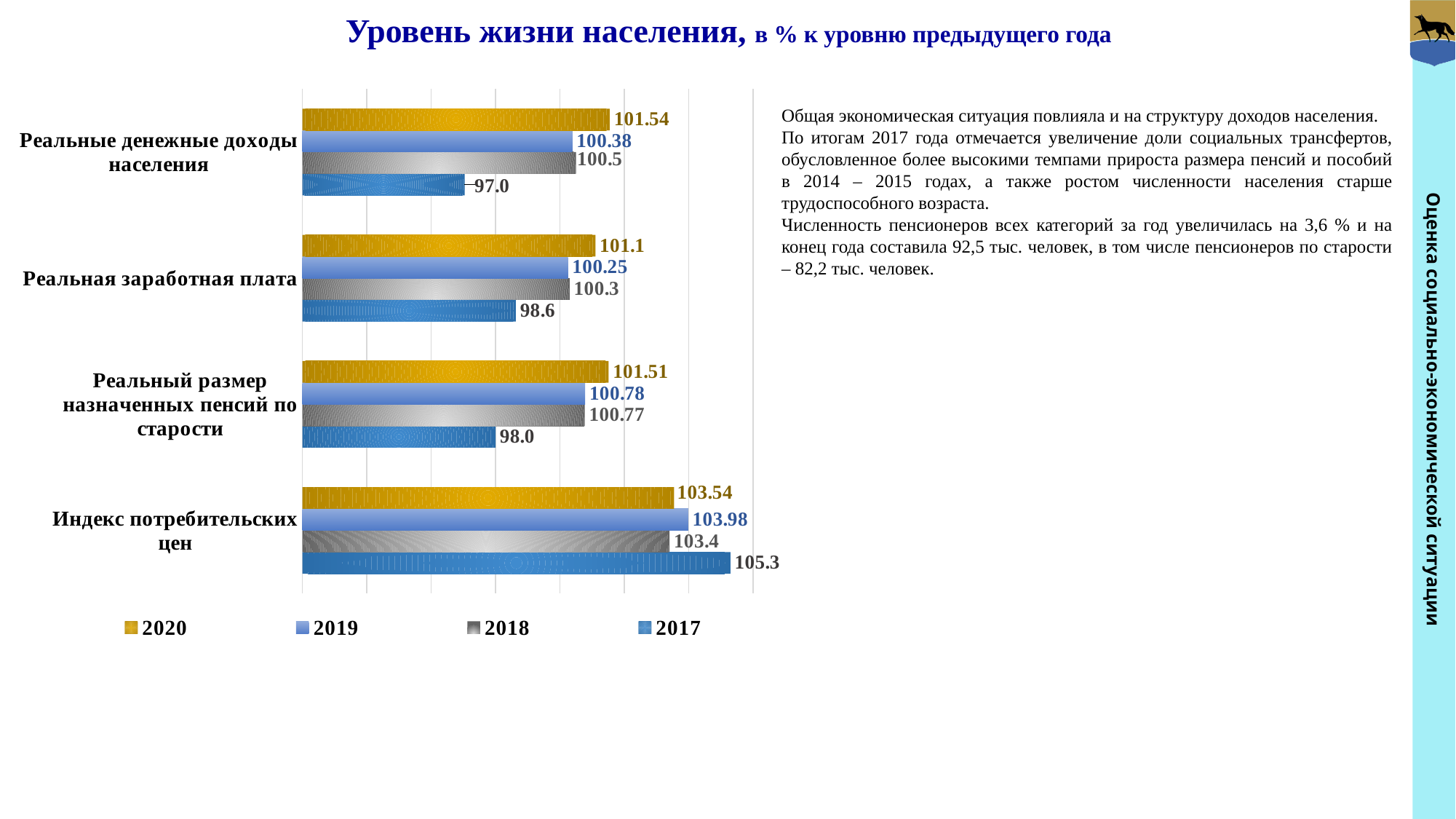
Which series is shown in gold/yellow on the chart? 2020 How many series does the legend list? 4 What is the value for 2017 for Индекс потребительских цен? 105.3 Which is larger for Реальный размер назначенных пенсий по старости: the 2020 value or the 2017 value? 2020 What is the difference between the 2020 and 2017 values for Реальная заработная плата? 2.5 What is the value for 2020 for Реальные денежные доходы населения? 101.54 Which year has the highest value for Индекс потребительских цен? 2017 Which year has the lowest value for Реальные денежные доходы населения? 2017 What is the value for 2019 for Реальная заработная плата? 100.25 How many categories are shown on the chart? 4 What kind of chart is shown on the slide? Bar chart What is the value for 2018 for Реальный размер назначенных пенсий по старости? 100.77